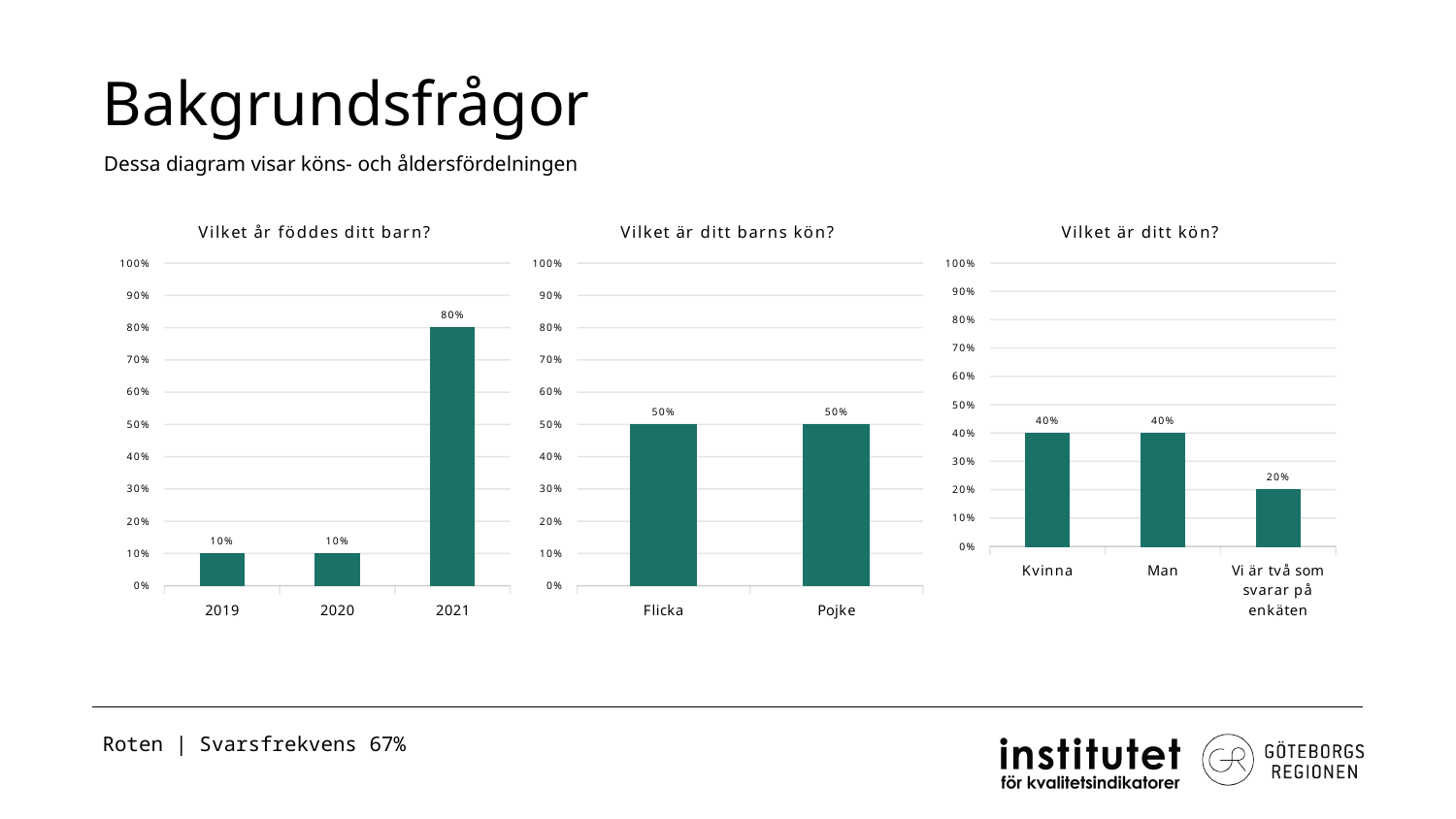
In the chart titled "Vilket är ditt kön?", which category has the lowest value? Vi är två som svarar på enkäten In the chart titled "Vilket är ditt barns kön?", what is the value for Flicka? 50% In the chart titled "Vilket år föddes ditt barn?", what is the value for 2021? 80% In the chart titled "Vilket år föddes ditt barn?", how many categories are shown on the x axis? 3 How many charts are shown on the slide? 3 In the chart titled "Vilket är ditt kön?", what is the difference between the values for Man and "Vi är två som svarar på enkäten"? 20% In the chart titled "Vilket år föddes ditt barn?", which year has the highest value? 2021 In the chart titled "Vilket år föddes ditt barn?", what is the difference between the values for 2021 and 2019? 70% What kind of chart is the chart titled "Vilket är ditt barns kön?"? Bar chart In the chart titled "Vilket är ditt kön?", what is the value for Kvinna? 40% In the chart titled "Vilket är ditt barns kön?", what is the value for Pojke? 50% In the chart titled "Vilket är ditt kön?", what is the value for "Vi är två som svarar på enkäten"? 20%